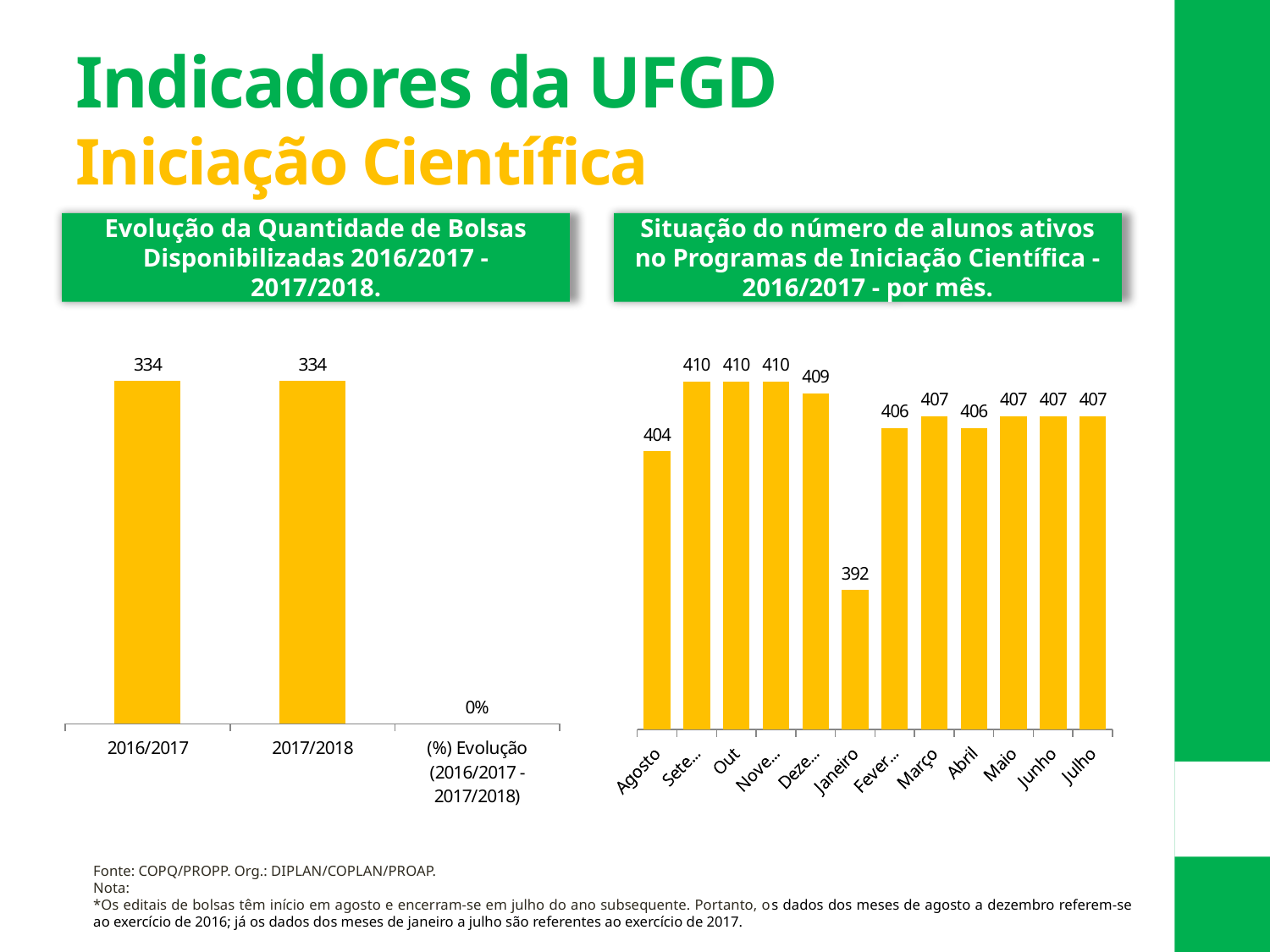
How many months are shown on the x axis of the right chart (Situação do número de alunos ativos)? 12 What type of chart is the right chart (Situação do número de alunos ativos)? Bar chart In the left chart (Evolução da Quantidade de Bolsas Disponibilizadas), what is the value for 2017/2018? 334 In the right chart (Situação do número de alunos ativos), which month has the lowest value? Janeiro In the left chart (Evolução da Quantidade de Bolsas Disponibilizadas), what is the value shown for (%) Evolução (2016/2017 - 2017/2018)? 0% In the right chart (Situação do número de alunos ativos), what is the difference between the values for Out and Janeiro? 18 In the right chart (Situação do número de alunos ativos), what is the value for Julho? 407 In the right chart (Situação do número de alunos ativos), what is the value for Janeiro? 392 In the left chart (Evolução da Quantidade de Bolsas Disponibilizadas), what is the difference between the values for 2016/2017 and 2017/2018? 0 In the left chart (Evolução da Quantidade de Bolsas Disponibilizadas), what is the value for 2016/2017? 334 In the right chart (Situação do número de alunos ativos), which is larger, the value for Março or the value for Abril? Março In the right chart (Situação do número de alunos ativos), what is the value for Agosto? 404